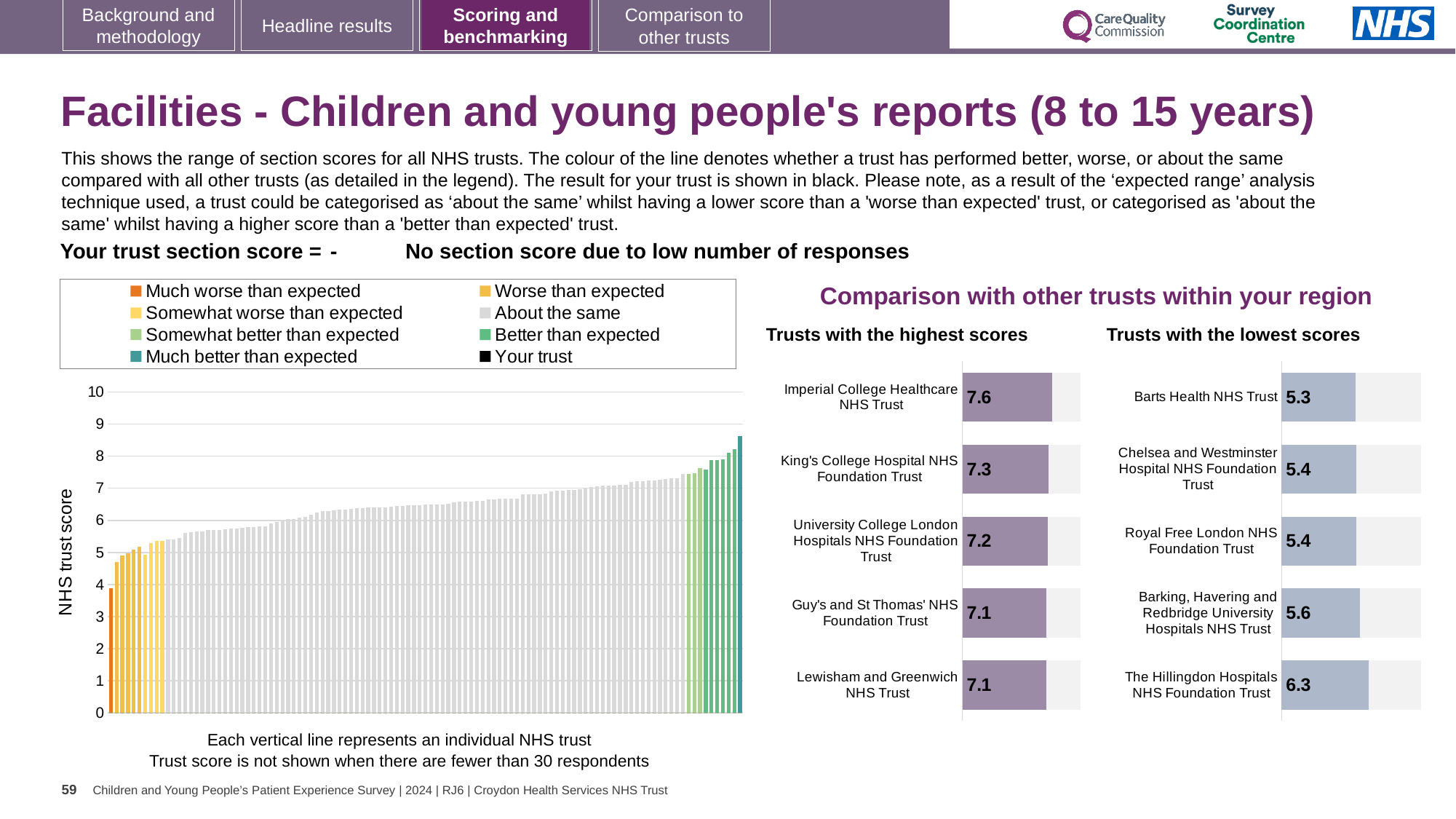
In the 'Trusts with the lowest scores' chart, which trust has the lowest score? Barts Health NHS Trust In the 'Trusts with the highest scores' chart, which trust has the highest score? Imperial College Healthcare NHS Trust In the large chart on the left, is the value of the tallest bar greater or less than 8? greater In the 'Trusts with the lowest scores' chart, how much higher is The Hillingdon Hospitals NHS Foundation Trust's score than Barts Health NHS Trust's score? 1.0 In the 'Trusts with the lowest scores' chart, which has the larger score: Barking, Havering and Redbridge University Hospitals NHS Trust or Royal Free London NHS Foundation Trust? Barking, Havering and Redbridge University Hospitals NHS Trust In the 'Trusts with the lowest scores' chart, what is the score for The Hillingdon Hospitals NHS Foundation Trust? 6.3 In the large chart on the left, do the trust scores rise or fall from left to right? Rise In the 'Trusts with the highest scores' chart, what is the score for Imperial College Healthcare NHS Trust? 7.6 How many trusts are listed in the 'Trusts with the highest scores' chart? 5 What kind of chart is the large chart on the left showing all NHS trusts? Bar chart In the 'Trusts with the highest scores' chart, what is the difference between the scores of Imperial College Healthcare NHS Trust and King's College Hospital NHS Foundation Trust? 0.3 In the 'Trusts with the highest scores' chart, what is the score for Guy's and St Thomas' NHS Foundation Trust? 7.1